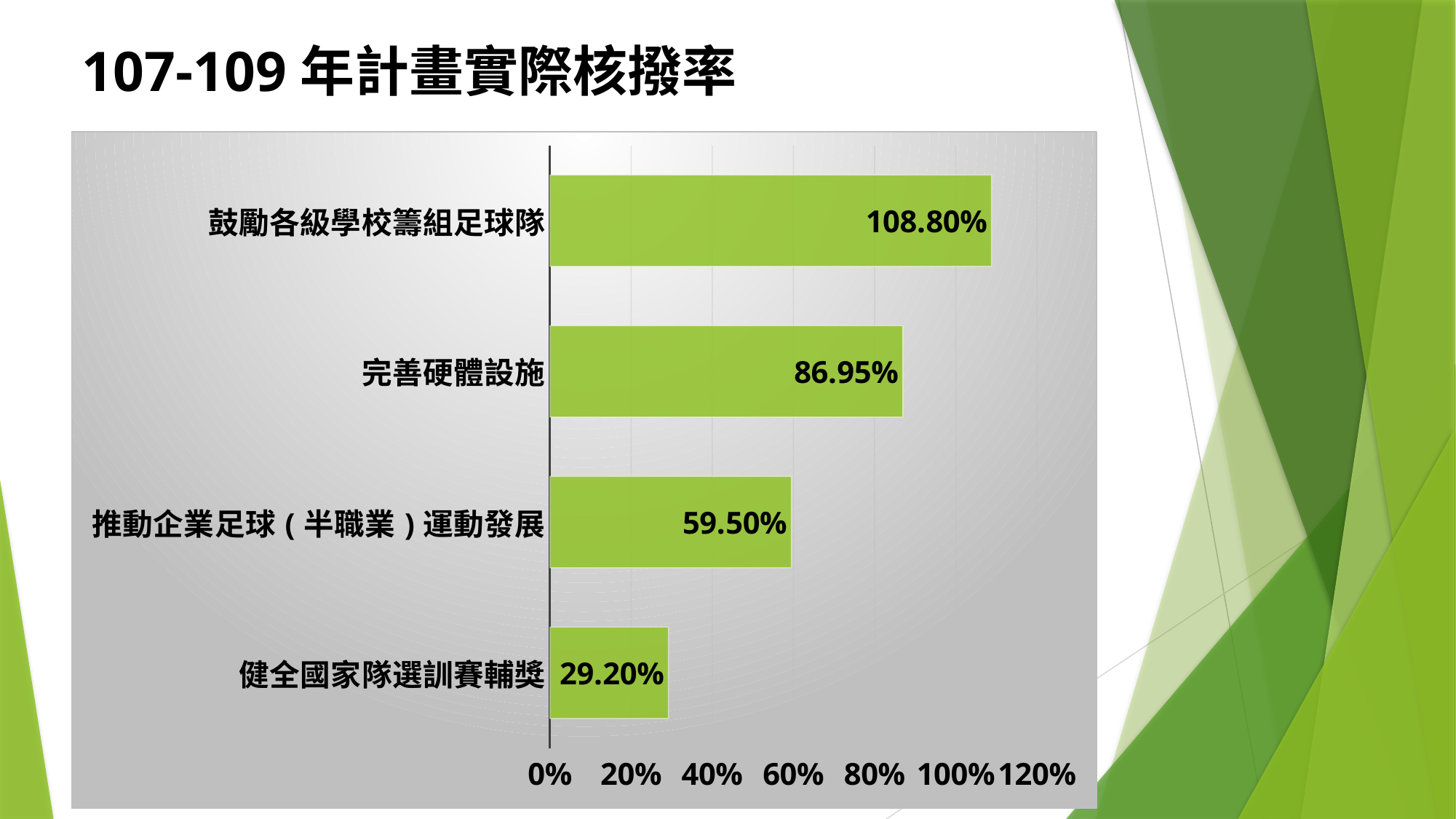
What is the value for 完善硬體設施? 86.95% Which category has the lowest value? 健全國家隊選訓賽輔獎 What is the value for 健全國家隊選訓賽輔獎? 29.20% Which category has the highest value? 鼓勵各級學校籌組足球隊 What is the value for 推動企業足球（半職業）運動發展? 59.50% Is the value for 完善硬體設施 greater or less than 100%? less What is the difference between the values for 鼓勵各級學校籌組足球隊 and 完善硬體設施? 21.85% What is the difference between the values for 推動企業足球（半職業）運動發展 and 健全國家隊選訓賽輔獎? 30.30% How many categories are shown in the chart? 4 What is the value for 鼓勵各級學校籌組足球隊? 108.80% Which is larger, the value for 完善硬體設施 or the value for 推動企業足球（半職業）運動發展? 完善硬體設施 What kind of chart is shown on the slide? bar chart